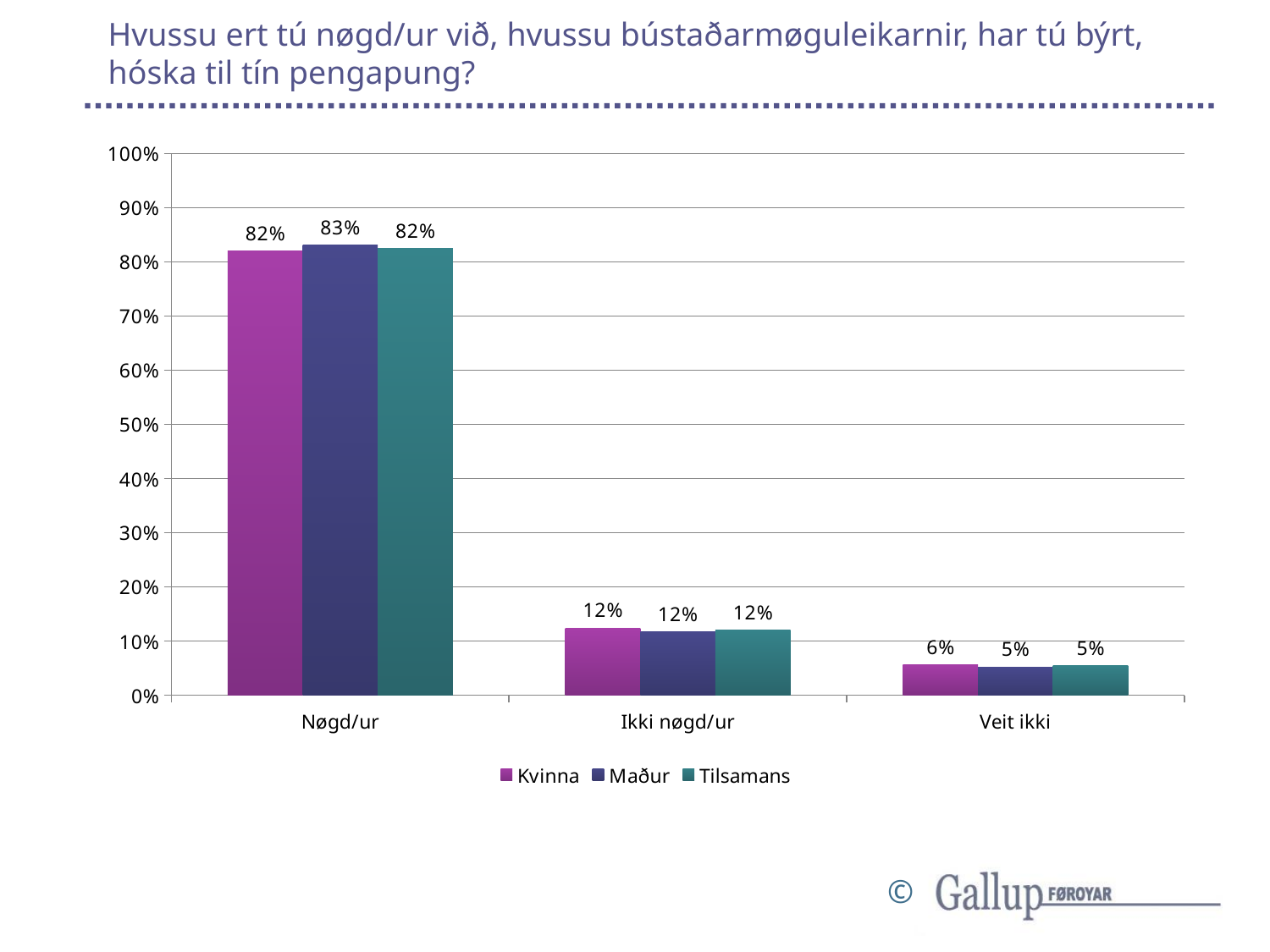
What is the value for Kvinna in the Veit ikki category? 6% What is the value for Maður in the Nøgd/ur category? 83% How many series does the legend list? 3 What is the value for Tilsamans in the Ikki nøgd/ur category? 12% What is the difference between the Kvinna values for Nøgd/ur and Ikki nøgd/ur? 70% Which is larger: the Kvinna value for Ikki nøgd/ur or the Kvinna value for Veit ikki? Ikki nøgd/ur What kind of chart is shown on the slide? Bar chart Which category has the highest value for Tilsamans? Nøgd/ur What is the value for Maður in the Veit ikki category? 5% What is the value for Kvinna in the Nøgd/ur category? 82% Which category has the lowest value for Kvinna? Veit ikki How many categories are shown on the x axis? 3